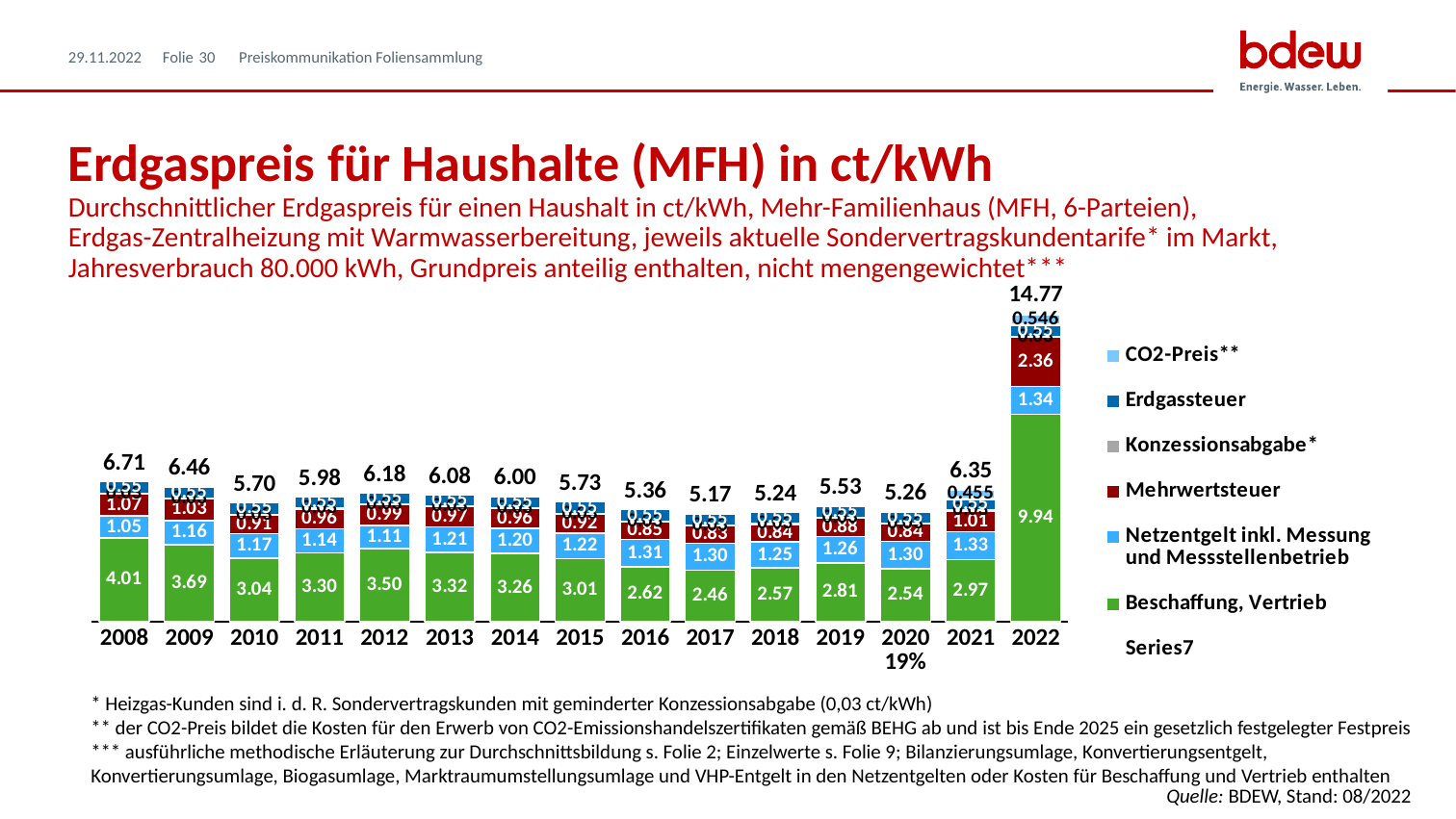
What is the total gas price shown above the bar for 2022? 14.77 Which year has the highest total gas price? 2022 What is the value of the Beschaffung, Vertrieb segment for 2008? 4.01 Which year has the lowest total gas price? 2017 What kind of chart is shown on the slide? Stacked bar chart What is the title of the chart on the slide? Erdgaspreis für Haushalte (MFH) in ct/kWh How many years are shown on the x axis? 15 What is the Mehrwertsteuer value for 2022? 2.36 How many entries does the legend list? 7 What is the Netzentgelt inkl. Messung und Messstellenbetrieb value for 2016? 1.31 Which year has a larger Beschaffung, Vertrieb value, 2012 or 2013? 2012 What is the difference between the total gas price in 2022 and in 2021? 8.42